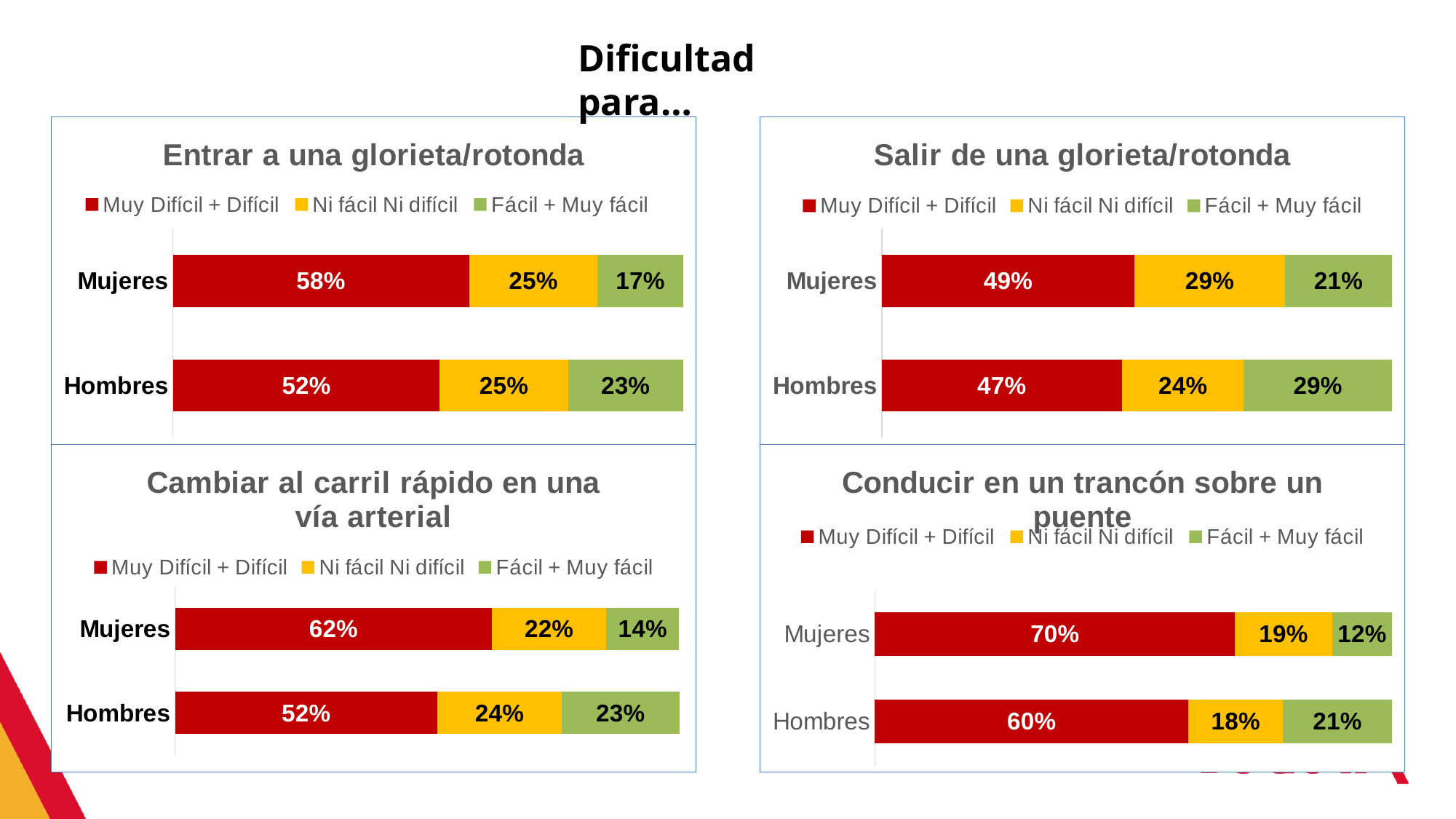
In the 'Salir de una glorieta/rotonda' chart, what is the difference between the 'Ni fácil Ni difícil' values for Mujeres and Hombres? 5% In the 'Cambiar al carril rápido en una vía arterial' chart, what colour represents 'Fácil + Muy fácil'? Green What kind of chart is the 'Salir de una glorieta/rotonda' chart? Stacked bar chart In the 'Cambiar al carril rápido en una vía arterial' chart, what is the 'Ni fácil Ni difícil' value for Hombres? 24% In the 'Entrar a una glorieta/rotonda' chart, which group has the larger 'Fácil + Muy fácil' value, Mujeres or Hombres? Hombres In the 'Cambiar al carril rápido en una vía arterial' chart, which group has the higher 'Muy Difícil + Difícil' value? Mujeres In the 'Entrar a una glorieta/rotonda' chart, what is the 'Muy Difícil + Difícil' value for Mujeres? 58% How many series does the legend of the 'Entrar a una glorieta/rotonda' chart list? 3 In the 'Conducir en un trancón sobre un puente' chart, what is the 'Muy Difícil + Difícil' value for Mujeres? 70% In the 'Salir de una glorieta/rotonda' chart, what is the 'Fácil + Muy fácil' value for Hombres? 29% In the 'Conducir en un trancón sobre un puente' chart, what is the difference between the 'Muy Difícil + Difícil' values for Mujeres and Hombres? 10% How many categories are shown in the 'Conducir en un trancón sobre un puente' chart? 2